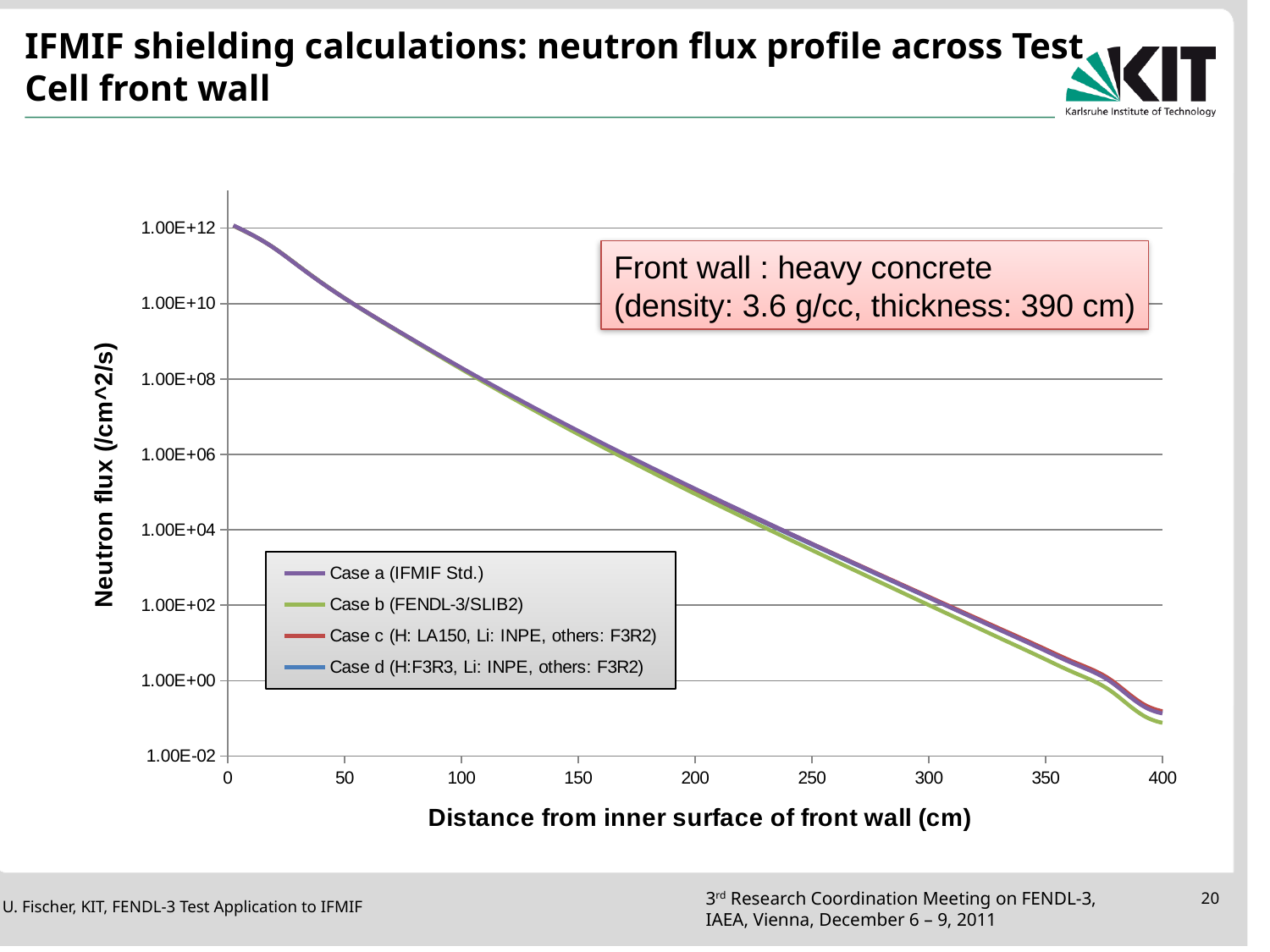
What is the title of the x axis of the chart? Distance from inner surface of front wall (cm) What is the first series listed in the chart legend? Case a (IFMIF Std.) Is the neutron flux for Case a (IFMIF Std.) at a distance of 200 cm greater or less than 1.00E+04? greater Is the neutron flux at a distance of 0 cm greater or less than 1.00E+10? greater Do the neutron flux values rise or fall as the distance from the inner surface of the front wall increases? fall Is the neutron flux for Case b (FENDL-3/SLIB2) at a distance of 400 cm greater or less than 1.00E+00? less What kind of chart is shown on the slide? line chart How many series does the legend list? 4 Which series has the lowest neutron flux at a distance of 400 cm? Case b (FENDL-3/SLIB2)